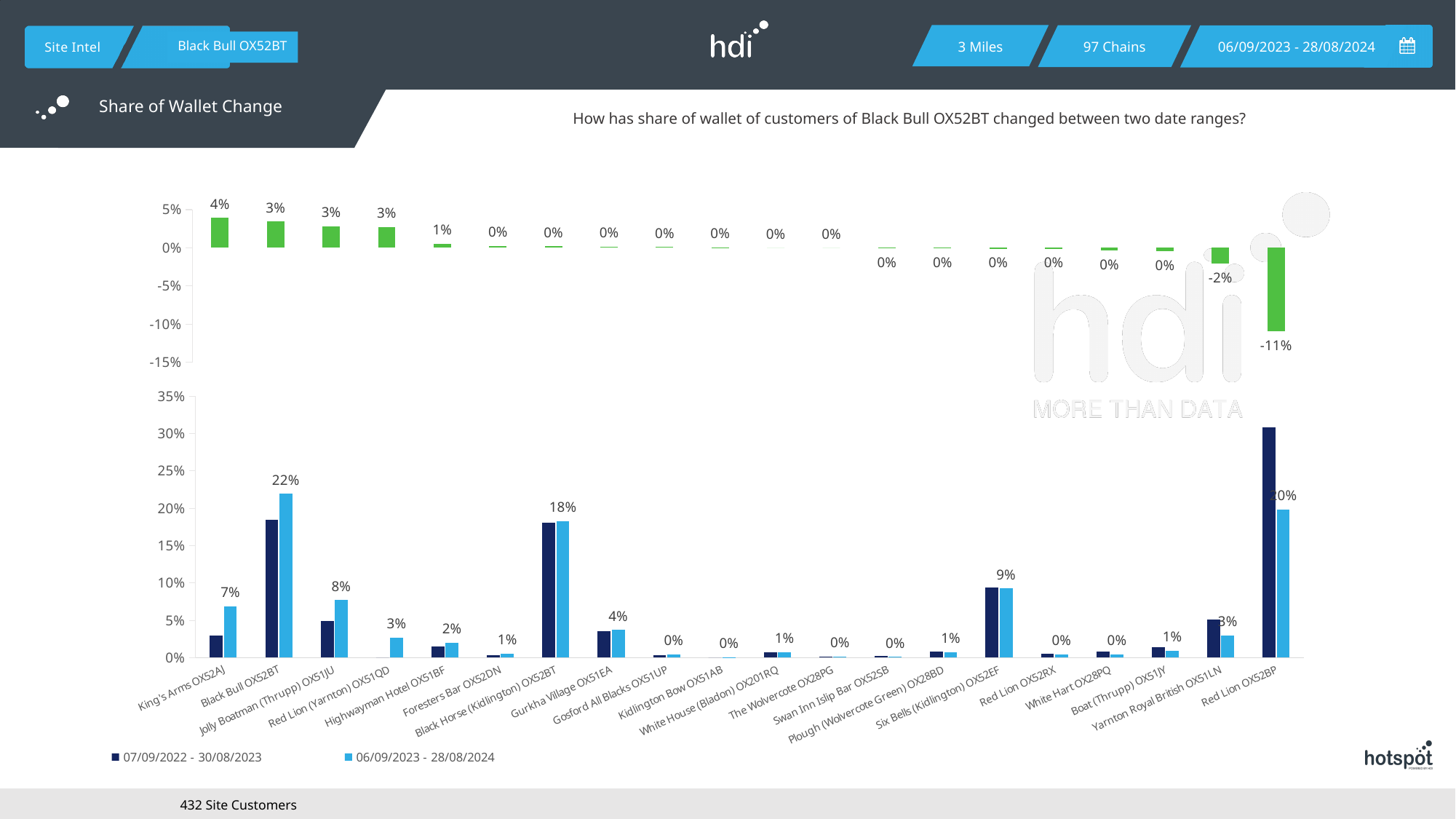
In the bottom chart, which has the larger 06/09/2023 - 28/08/2024 value: Black Bull OX52BT or Black Horse (Kidlington) OX52BT? Black Bull OX52BT In the top chart (share of wallet change), what is the difference between the values for King's Arms OX52AJ and Highwayman Hotel OX51BF? 3 percentage points In the top chart (share of wallet change), what is the value for King's Arms OX52AJ? 4% In the bottom chart, what is the 06/09/2023 - 28/08/2024 value for Black Bull OX52BT? 22% In the top chart (share of wallet change), what is the value for Red Lion OX52BP? -11% In the bottom chart, how many series does the legend list? 2 What kind of chart is the bottom chart? Bar chart In the bottom chart, is the 07/09/2022 - 30/08/2023 value for Red Lion OX52BP greater or less than 25%? greater In the top chart (share of wallet change), which category has the highest value? King's Arms OX52AJ In the top chart (share of wallet change), which category has the lowest value? Red Lion OX52BP In the top chart (share of wallet change), what is the value for Yarnton Royal British OX51LN? -2% In the bottom chart, how many categories are shown on the x axis? 20